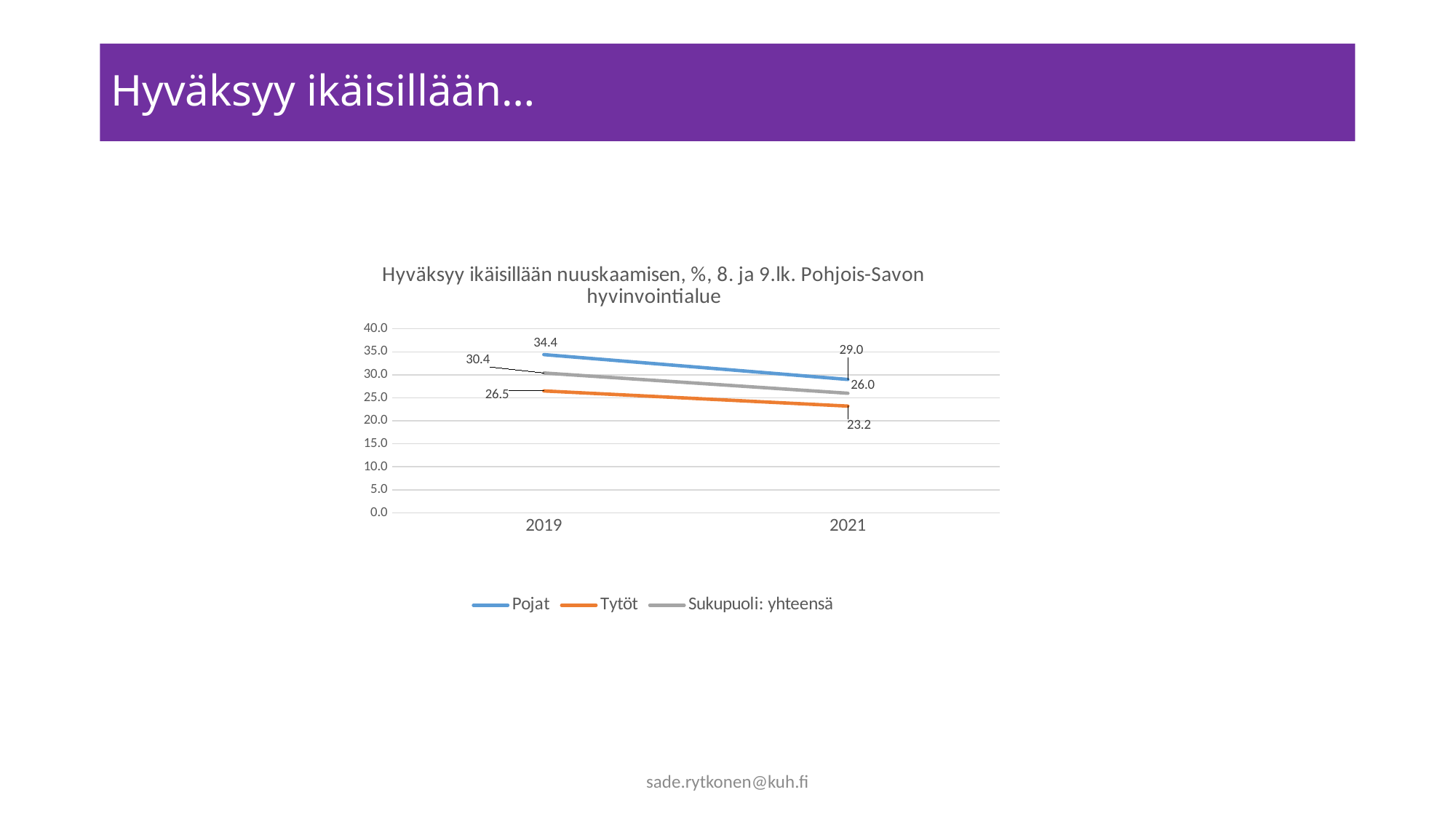
What is the value for Pojat in 2021? 29.0 What is the difference between the Pojat values in 2019 and 2021? 5.4 Which series has the highest value in 2019? Pojat Is the value for Tytöt in 2021 greater or less than 25.0? less How many series does the legend list? 3 Which is larger, the Tytöt value in 2019 or the Sukupuoli: yhteensä value in 2021? Tytöt in 2019 What is the value for Pojat in 2019? 34.4 What is the value for Tytöt in 2021? 23.2 What is the value for Sukupuoli: yhteensä in 2019? 30.4 Do the values for Sukupuoli: yhteensä rise or fall from 2019 to 2021? fall Which series has the lowest value in 2021? Tytöt What kind of chart is shown on the slide? line chart